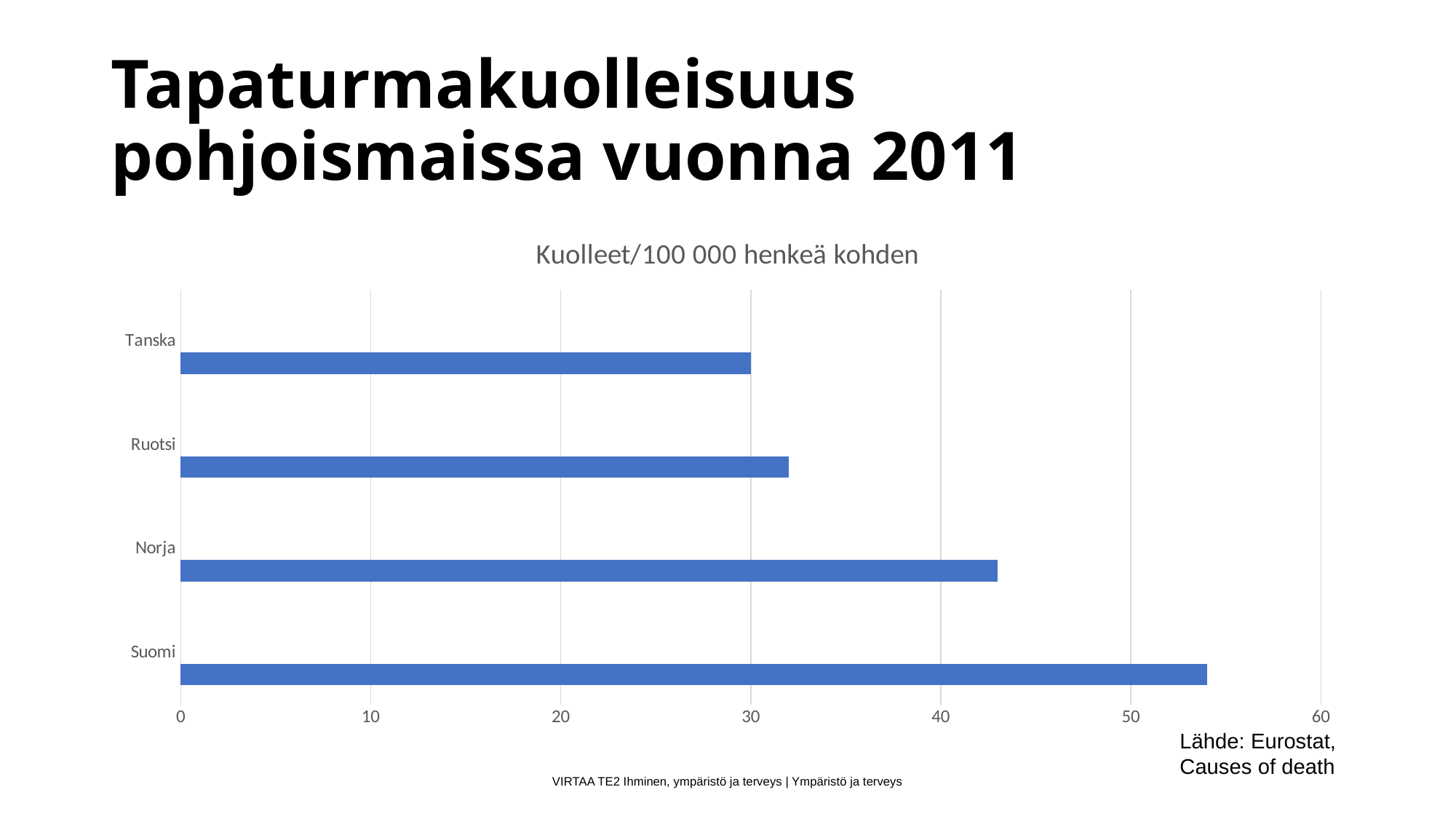
Is the value for Suomi greater or less than 50? greater Which has a larger value, Norja or Ruotsi? Norja Is the value for Ruotsi greater or less than 40? less Is the value for Norja greater or less than 40? greater What kind of chart is shown on the slide? bar chart Which has a larger value, Suomi or Norja? Suomi How many countries are shown in the chart? 4 Which country has the lowest value in the chart? Tanska What is the highest value shown on the horizontal axis? 60 Which country has the highest value in the chart? Suomi What is the title of the chart? Kuolleet/100 000 henkeä kohden